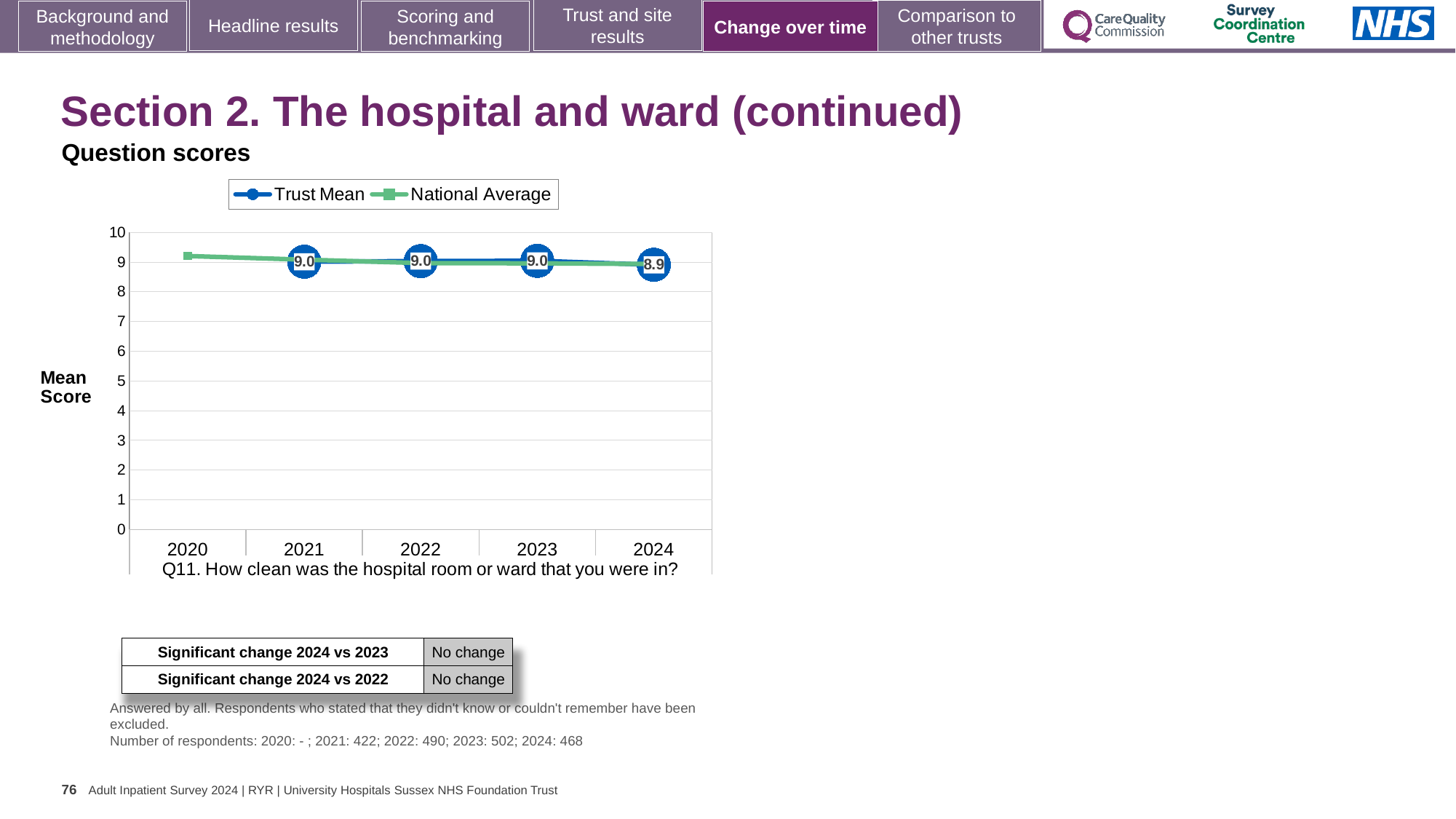
In which year is the Trust Mean lowest? 2024 How many years are shown on the x axis of the chart? 5 What is the Trust Mean value for 2022? 9.0 What is the difference between the Trust Mean in 2023 and in 2024? 0.1 How many series does the chart legend list? 2 What is the Trust Mean value for 2024? 8.9 What kind of chart is shown on the slide? Line chart What is the Trust Mean value for 2021? 9.0 What is the Trust Mean value for 2023? 9.0 Is the National Average value for 2020 greater or less than 8? greater What is the label on the y axis of the chart? Mean Score Does the Trust Mean rise or fall between 2023 and 2024? Fall